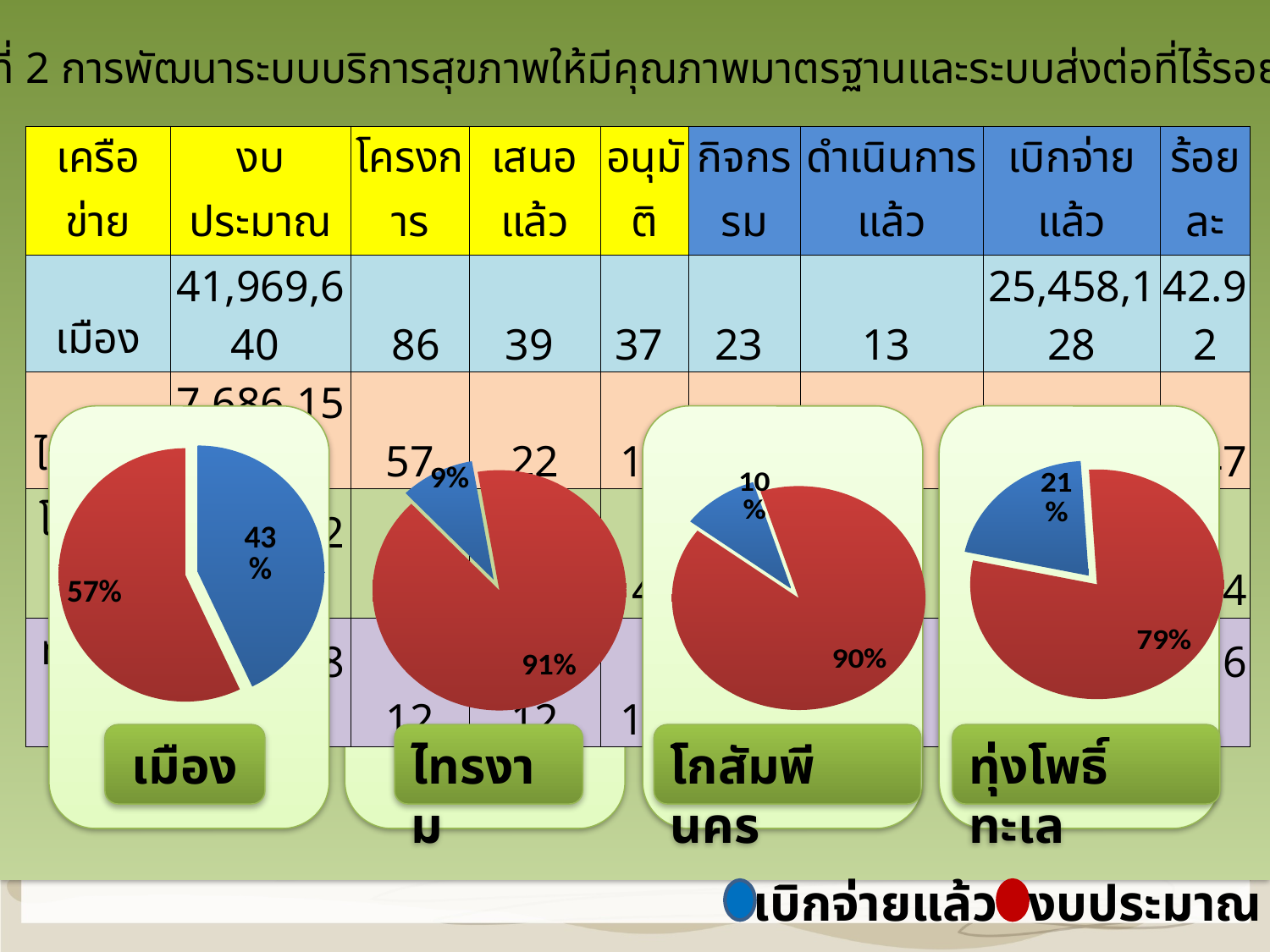
In the pie chart labelled เมือง, what percentage is shown for the blue slice (เบิกจ่ายแล้ว)? 43% In the pie chart labelled โกสัมพีนคร, what percentage is shown for the red slice (งบประมาณ)? 90% Across the four pie charts, which one has the smallest blue (เบิกจ่ายแล้ว) share? ไทรงาม In the pie chart labelled ไทรงาม, what percentage is shown for the blue slice (เบิกจ่ายแล้ว)? 9% How many series does the legend at the bottom of the slide list for the pie charts? 2 Across the four pie charts, which one has the largest blue (เบิกจ่ายแล้ว) share? เมือง What type of chart is used for เมือง, ไทรงาม, โกสัมพีนคร and ทุ่งโพธิ์ทะเล? Pie chart In the pie chart labelled ทุ่งโพธิ์ทะเล, what percentage is shown for the blue slice (เบิกจ่ายแล้ว)? 21% In the pie chart labelled ทุ่งโพธิ์ทะเล, what percentage is shown for the red slice (งบประมาณ)? 79% Which is larger: the blue slice in the โกสัมพีนคร pie chart or the blue slice in the ทุ่งโพธิ์ทะเล pie chart? ทุ่งโพธิ์ทะเล In the pie chart labelled เมือง, what percentage is shown for the red slice (งบประมาณ)? 57% In the pie chart labelled เมือง, what is the difference between the red slice and the blue slice? 14%